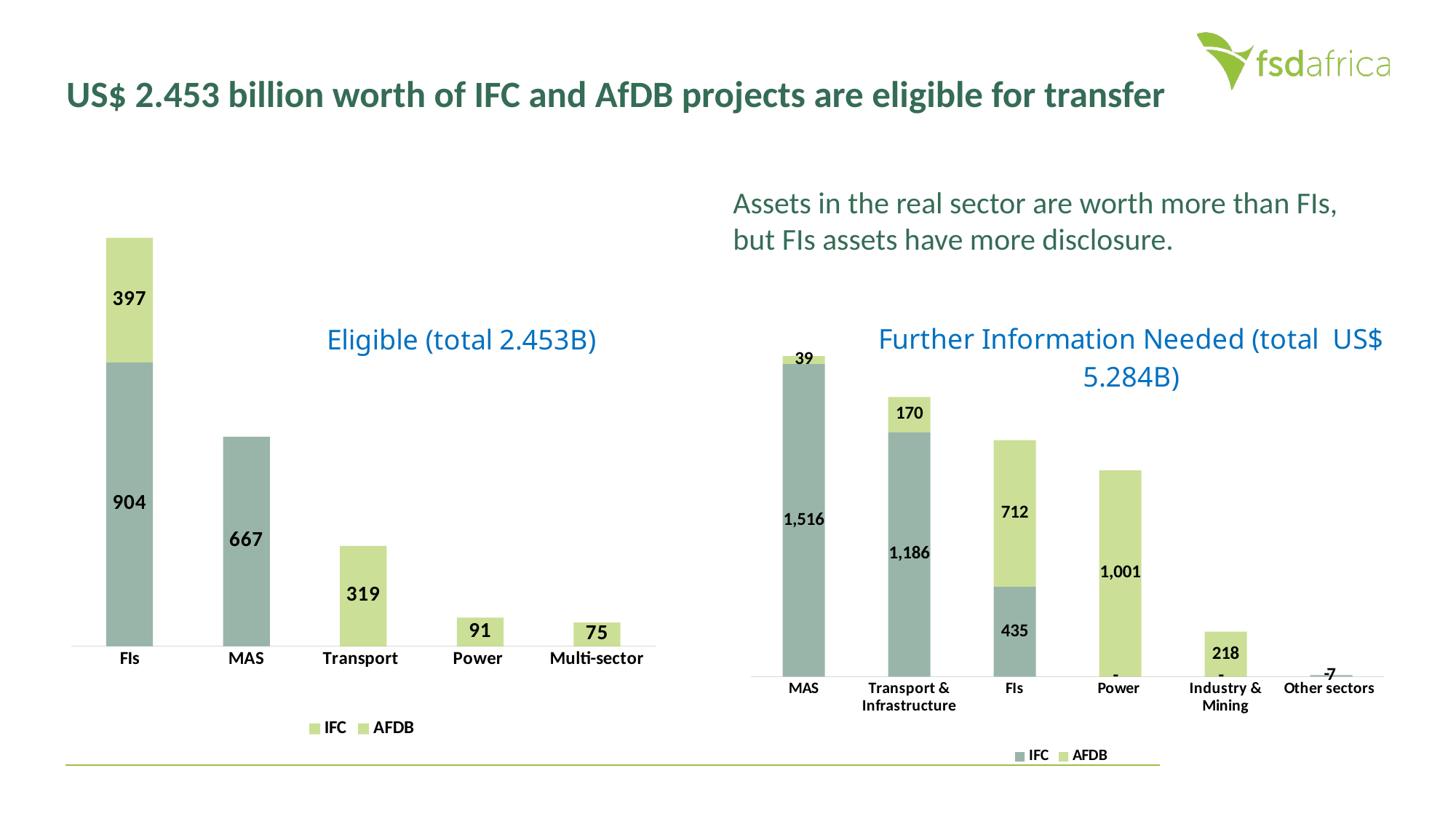
In the 'Eligible (total 2.453B)' chart, what is the total of the stacked bar for FIs? 1,301 In the 'Further Information Needed' chart on the right, how many categories are shown on the x axis? 6 In the 'Eligible (total 2.453B)' chart, what is the value shown for MAS? 667 What kind of chart is the 'Eligible (total 2.453B)' chart on the left? bar chart In the 'Eligible (total 2.453B)' chart, how many categories are shown on the x axis? 5 In the 'Further Information Needed' chart, what is the total of the stacked bar for Transport & Infrastructure? 1,356 In the 'Further Information Needed' chart, what is the AFDB value for FIs? 712 How many series does the legend of the 'Further Information Needed' chart list? 2 In the 'Further Information Needed' chart, which is larger: the AFDB value for Power or the AFDB value for FIs? Power In the 'Eligible (total 2.453B)' chart, what is the difference between the Transport value and the Power value? 228 In the 'Eligible (total 2.453B)' chart, which category has the lowest value? Multi-sector In the 'Further Information Needed' chart, what is the IFC value for MAS? 1,516